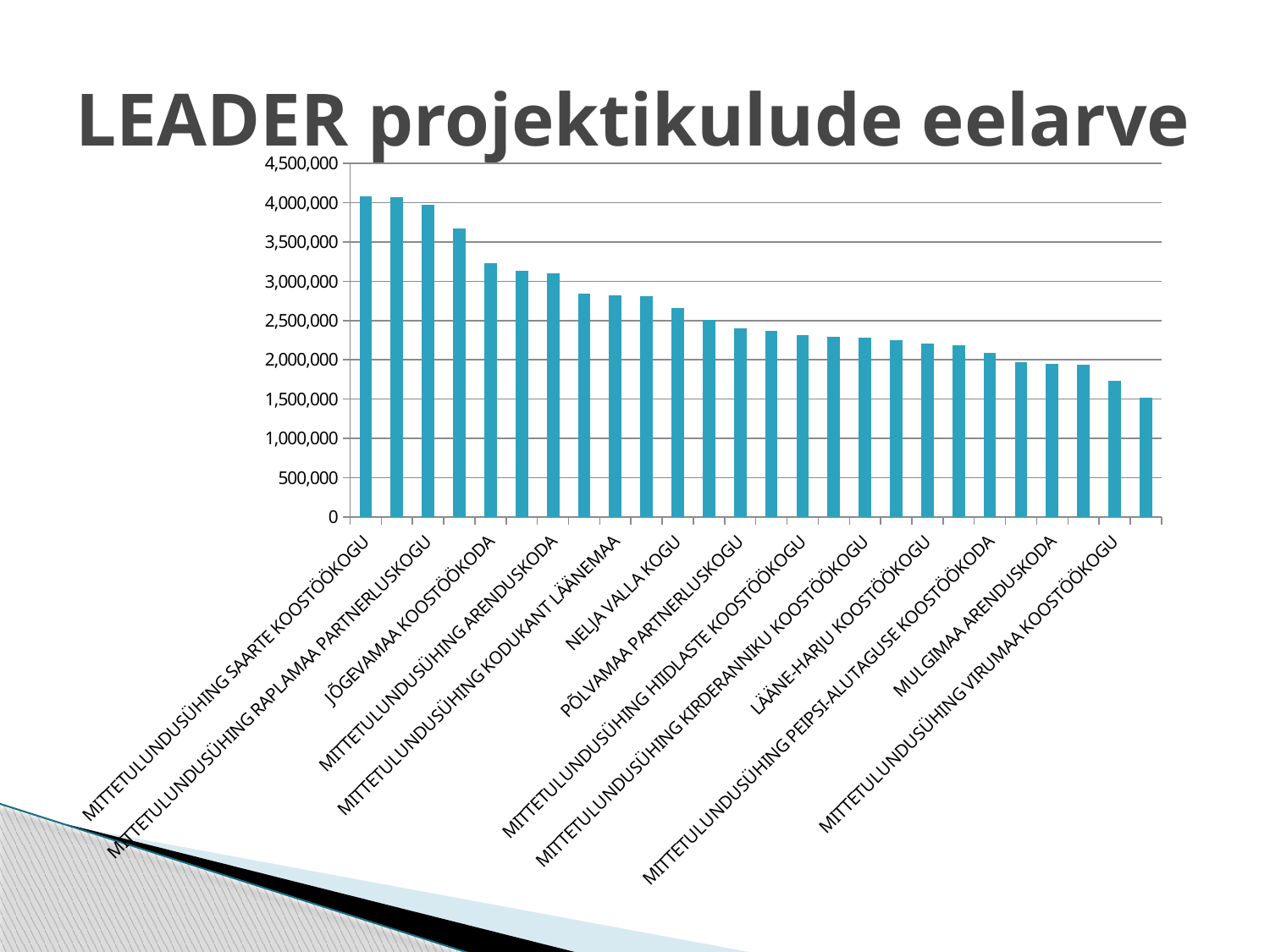
Is the value for PÕLVAMAA PARTNERLUSKOGU greater or less than 2,500,000? less Is the value for MITTETULUNDUSÜHING VIRUMAA KOOSTÖÖKOGU greater or less than 2,000,000? less How many bars are plotted in the chart? 26 Which has the larger value, JÕGEVAMAA KOOSTÖÖKODA or NELJA VALLA KOGU? JÕGEVAMAA KOOSTÖÖKODA Do the bar values rise or fall from left to right along the x axis? fall Is the value for MITTETULUNDUSÜHING KODUKANT LÄÄNEMAA greater or less than 2,500,000? greater Which has the larger value, MITTETULUNDUSÜHING SAARTE KOOSTÖÖKOGU or MITTETULUNDUSÜHING VIRUMAA KOOSTÖÖKOGU? MITTETULUNDUSÜHING SAARTE KOOSTÖÖKOGU What kind of chart is shown on the slide? bar chart What is the title of the slide? LEADER projektikulude eelarve What is the highest value shown on the vertical axis? 4,500,000